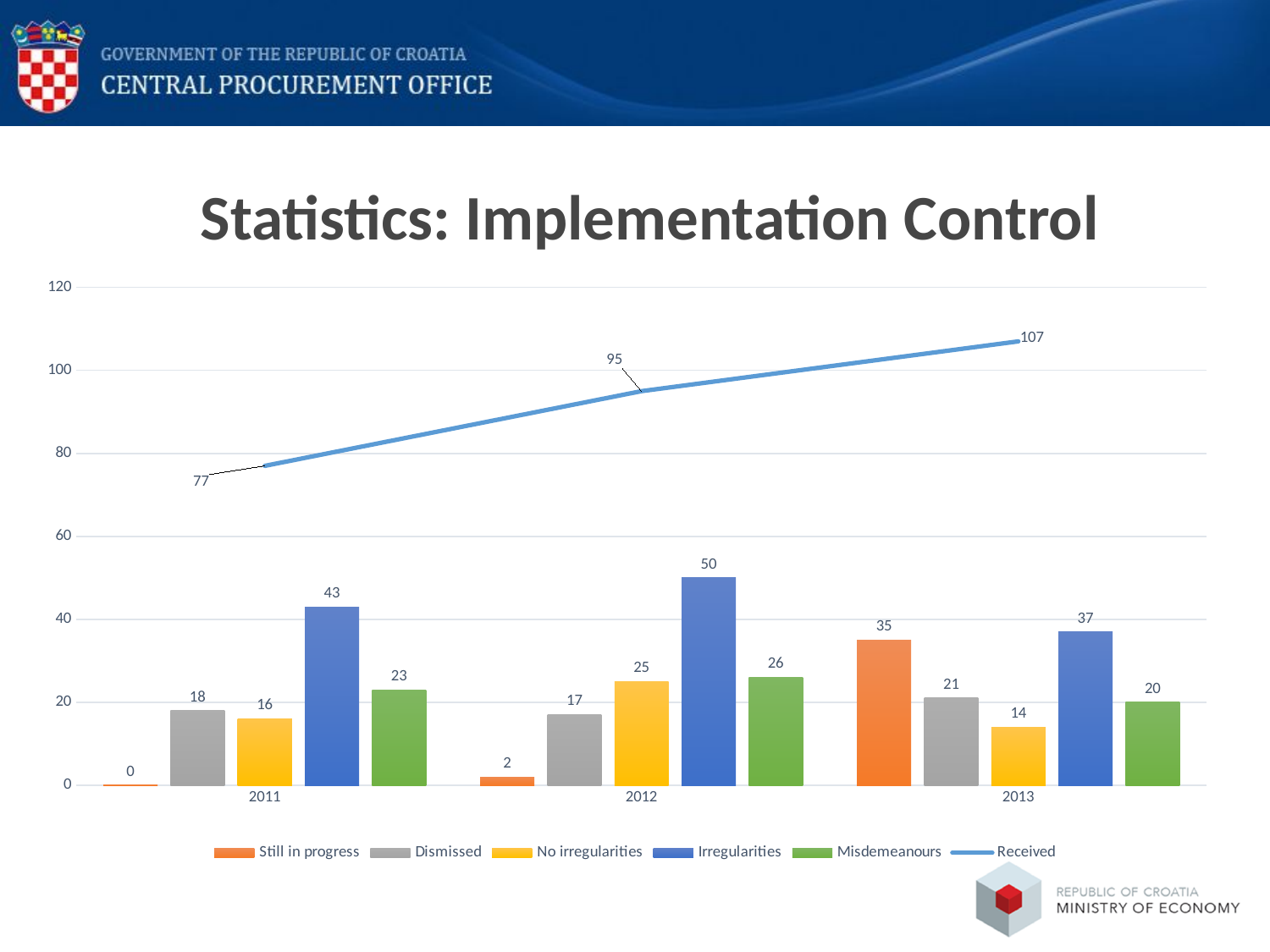
What is the value of Still in progress in 2011? 0 How many series does the legend list? 6 What is the title of the chart? Statistics: Implementation Control What is the value of Received in 2013? 107 What is the value of Misdemeanours in 2013? 20 Does the Received line rise or fall from 2011 to 2013? rise In which year is the Dismissed bar lowest? 2012 How many years are shown on the x axis? 3 Which is larger in 2013: Still in progress or Irregularities? Irregularities What is the difference between Received in 2013 and Received in 2011? 30 What is the value of Irregularities in 2012? 50 In which year is the Received line highest? 2013